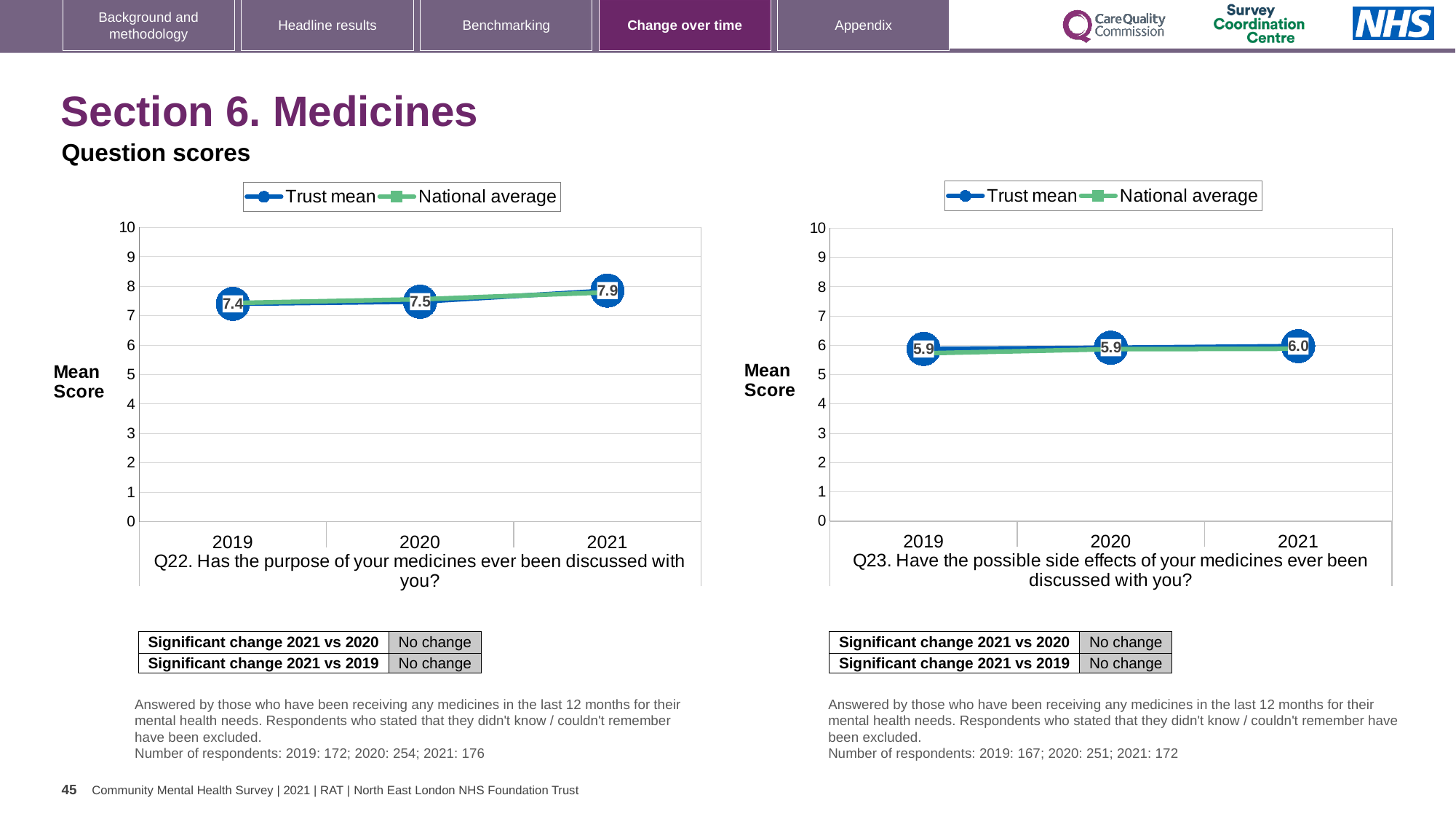
On the Q22 chart (left), what is the difference between the Trust mean for 2021 and 2019? 0.5 Which is larger: the Trust mean for 2021 on the Q22 chart (left) or the Trust mean for 2021 on the Q23 chart (right)? Q22 chart (7.9) What kind of chart is the Q22 chart (left)? Line chart On the Q23 chart (right), is the Trust mean for 2019 greater or less than 7? less How many years are plotted on the Q22 chart (left)? 3 On the Q22 chart (left), which year has the highest Trust mean? 2021 On the Q22 chart (left), what is the Trust mean for 2019? 7.4 On the Q23 chart (right), what is the Trust mean for 2020? 5.9 On the Q22 chart (left), what is the Trust mean for 2021? 7.9 How many series does the legend of the Q23 chart (right) list? 2 On the Q23 chart (right), what is the Trust mean for 2021? 6.0 On the Q22 chart (left), which year has the lowest Trust mean? 2019